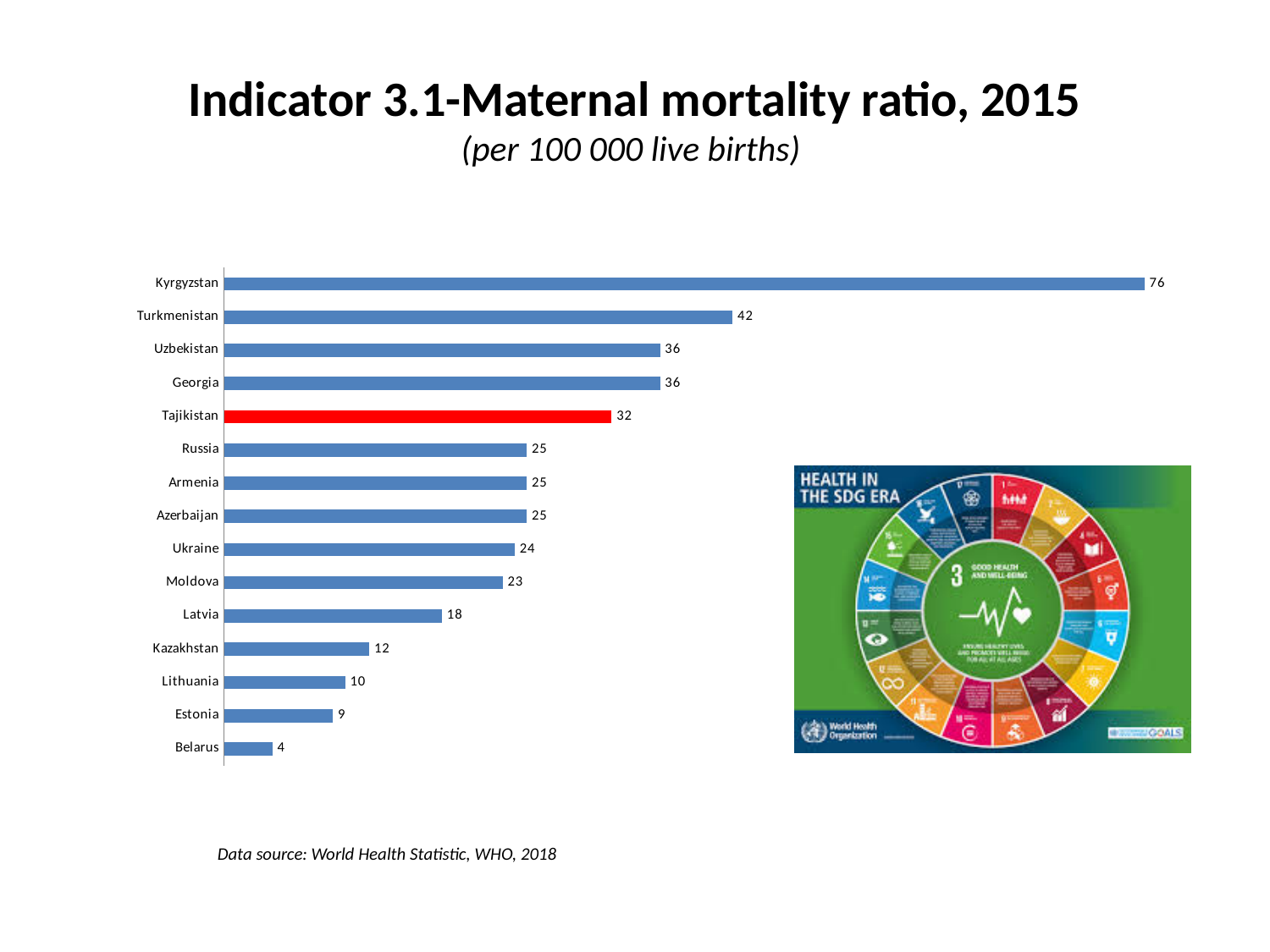
What kind of chart is shown on the slide? Bar chart What is the difference between the maternal mortality ratios of Tajikistan and Russia? 7 What is the maternal mortality ratio for Tajikistan? 32 What is the maternal mortality ratio for Belarus? 4 Which has a higher maternal mortality ratio, Turkmenistan or Georgia? Turkmenistan Which country has the highest maternal mortality ratio? Kyrgyzstan Which country's bar is highlighted in red? Tajikistan How many countries are shown in the chart? 15 Which has a higher maternal mortality ratio, Latvia or Kazakhstan? Latvia What is the difference between the maternal mortality ratios of Kyrgyzstan and Turkmenistan? 34 What is the maternal mortality ratio for Kyrgyzstan? 76 Which country has the lowest maternal mortality ratio? Belarus